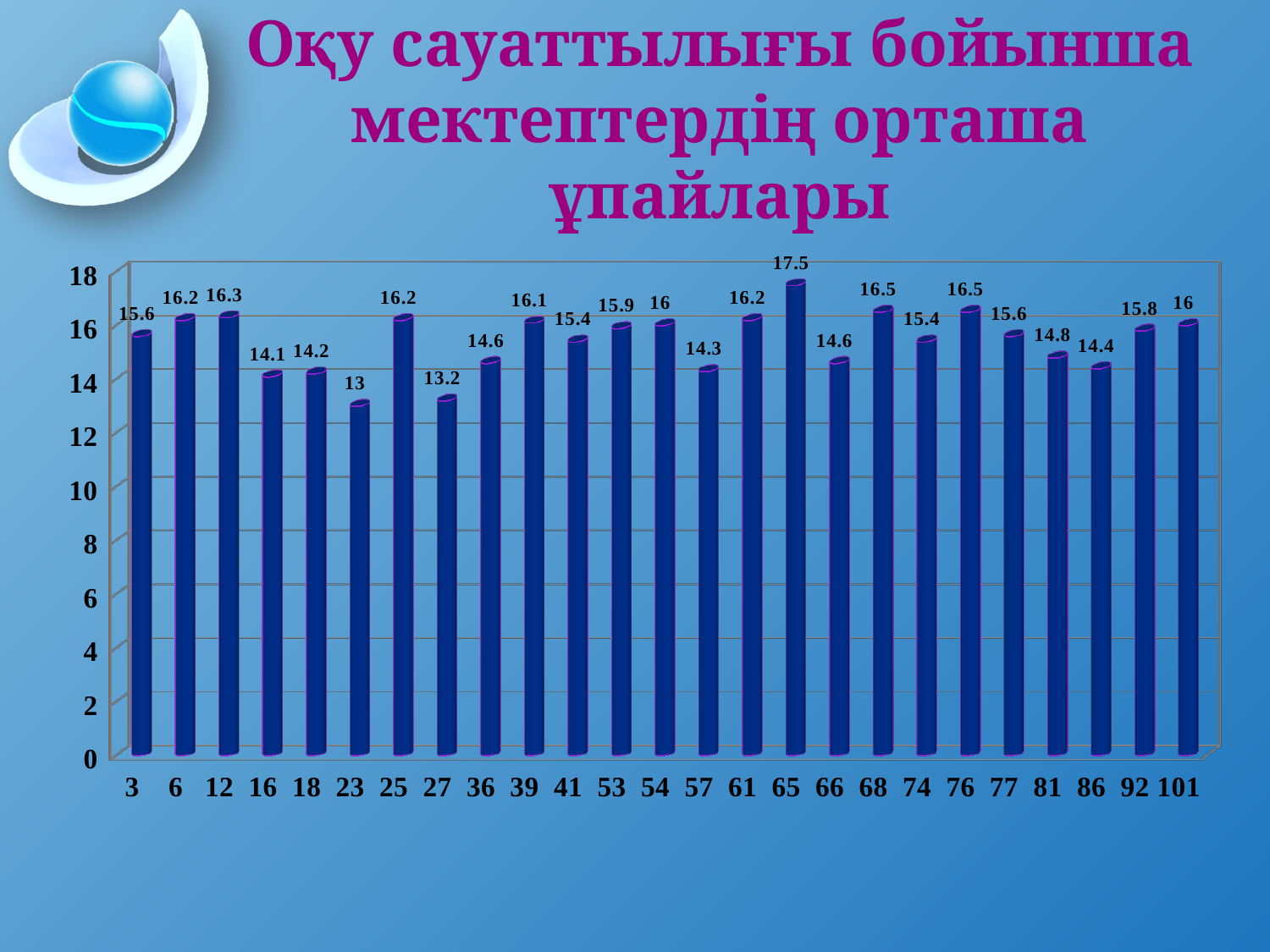
What is the difference between the values for school 12 and school 16? 2.2 What kind of chart is shown on the slide? Bar chart What is the value for school 101? 16 What is the difference between the values for school 65 and school 23? 4.5 Which school has the lowest value? 23 What is the value for school 23? 13 Which has a larger value, school 27 or school 25? 25 How many schools (categories) are shown on the x axis? 25 What is the value for school 65? 17.5 What is the value for school 36? 14.6 What is the title of the chart on the slide? Оқу сауаттылығы бойынша мектептердің орташа ұпайлары Which school has the highest value? 65